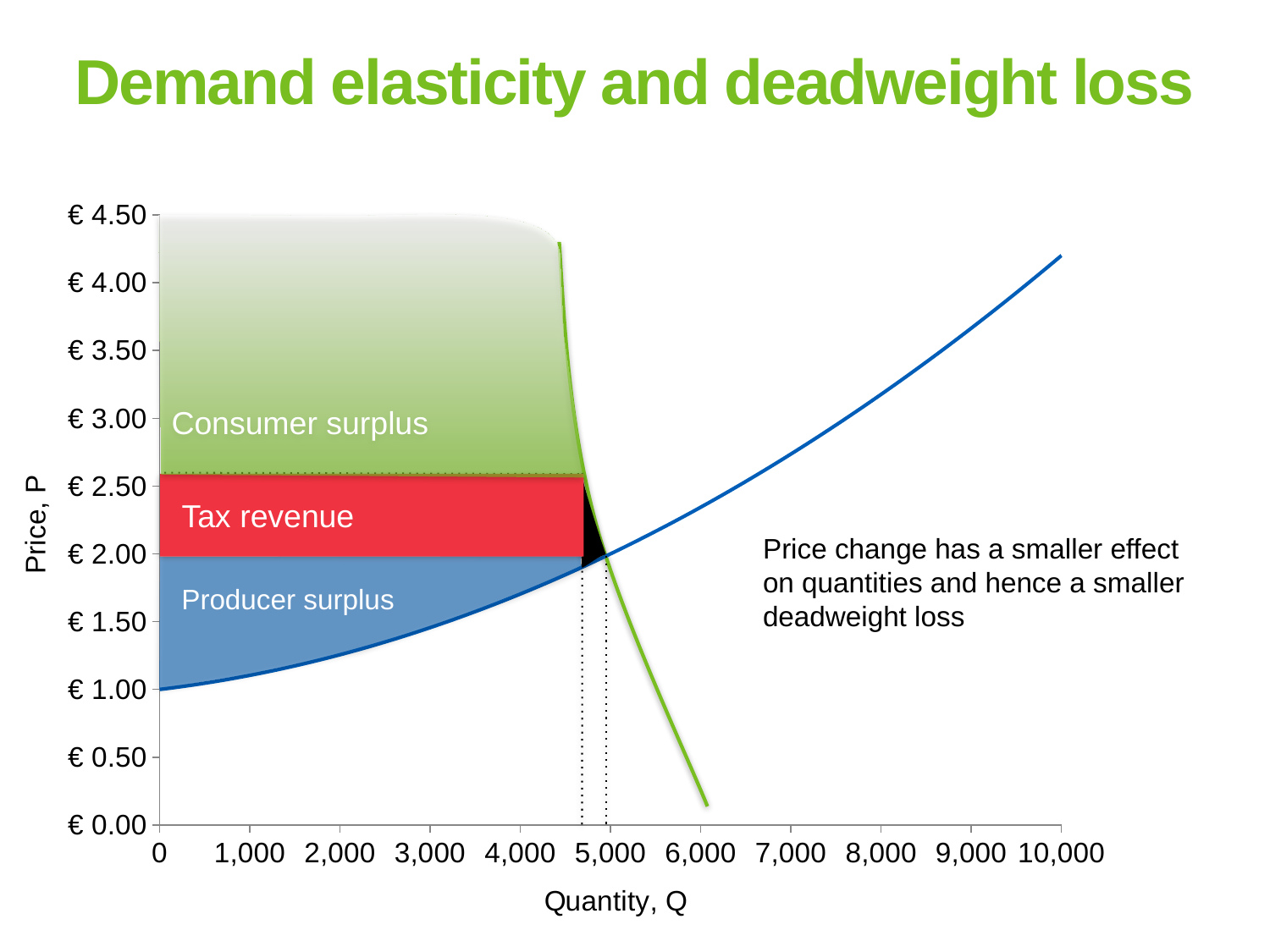
What is the price on the blue curve at a quantity of 0? € 1.00 Is the price on the blue curve at a quantity of 10,000 greater or less than € 4.00? greater What is the title of the chart on the slide? Demand elasticity and deadweight loss Does the blue curve rise or fall as quantity increases along the x axis? rise Does the green curve rise or fall as quantity increases along the x axis? fall How many tick labels are shown on the horizontal axis of the chart? 11 Is the price on the blue curve at a quantity of 8,000 greater or less than € 3.00? greater Is the price on the blue curve at a quantity of 2,000 greater or less than € 1.50? less What is the highest price value shown on the vertical axis? € 4.50 What kind of chart is shown on the slide? line chart What label is shown on the vertical axis of the chart? Price, P